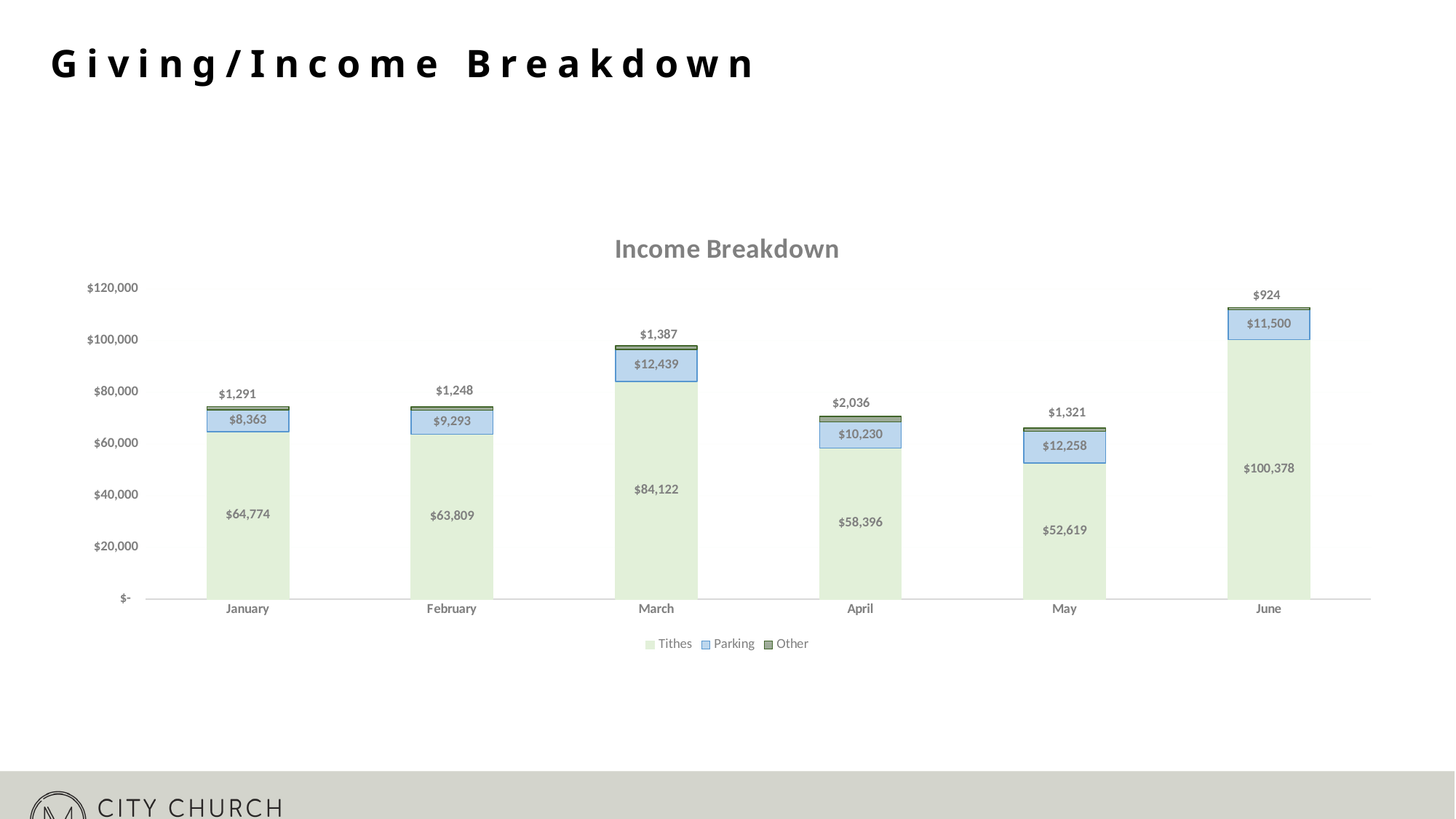
Which is larger, the Parking value for May or the Parking value for April? May How many months are shown on the x axis? 6 How many series does the legend list? 3 What type of chart is shown on the slide? Stacked bar chart What is the Other value for April? $2,036 Which month has the lowest Tithes value? May What is the Tithes value for March? $84,122 Which month has the lowest Other value? June What is the difference between the Tithes values for June and March? $16,256 What is the total of the stacked bar for June? $112,802 What is the Parking value for June? $11,500 Which month has the highest Tithes value? June